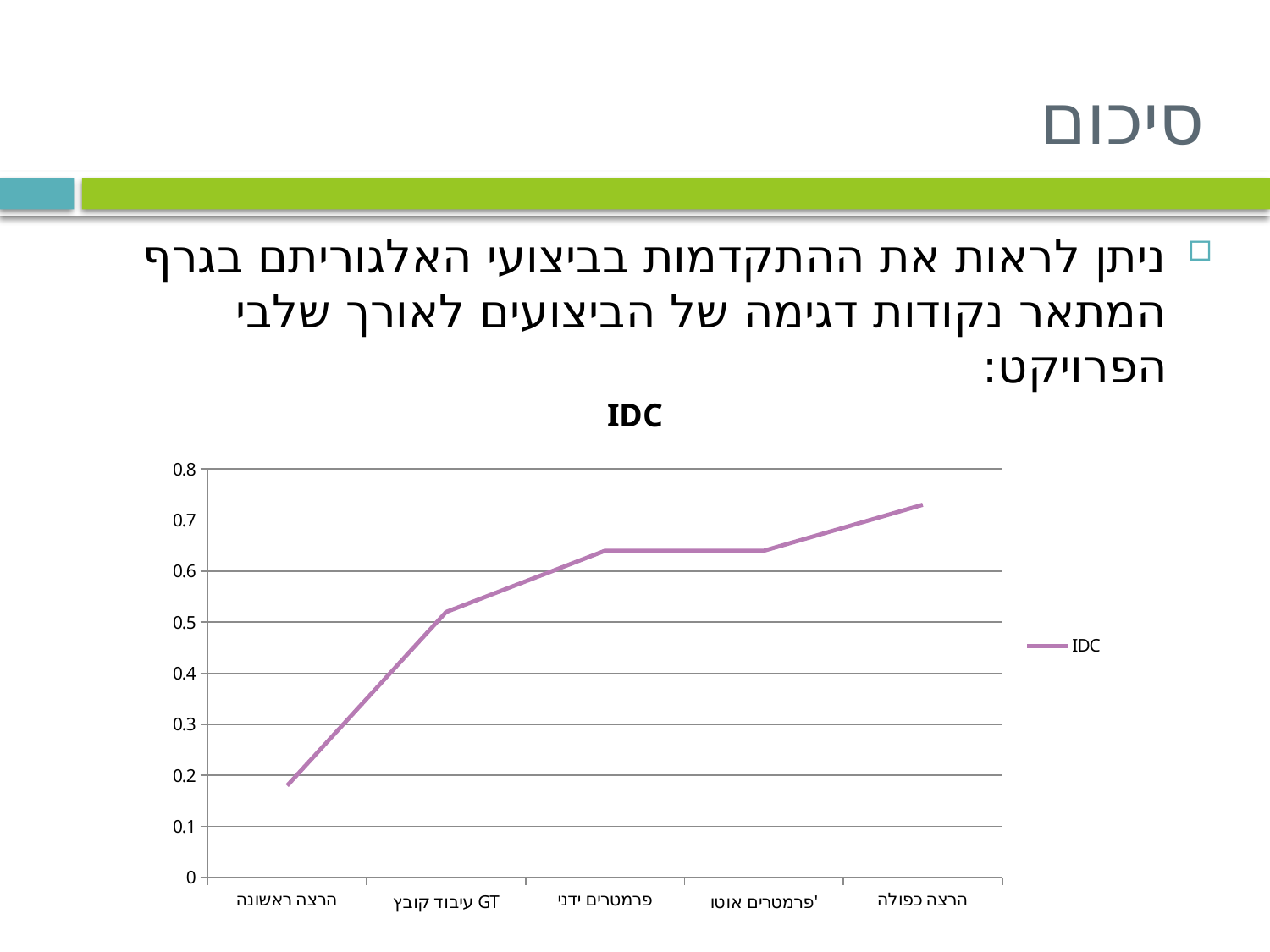
Is the IDC value for פרמטרים ידני greater or less than 0.6? greater What kind of chart is shown on the slide? line chart Do the IDC values generally rise or fall from left to right along the x axis? rise Is the IDC value for הרצה ראשונה greater or less than 0.3? less How many categories are shown on the x axis? 5 Is the IDC value for הרצה כפולה greater or less than 0.8? less What is the title of the chart? IDC Which has a larger IDC value, הרצה ראשונה or עיבוד קובץ GT? עיבוד קובץ GT What colour is the IDC line in the chart? purple Which category has the lowest IDC value? הרצה ראשונה How many series does the legend list? 1 Which category has the highest IDC value? הרצה כפולה